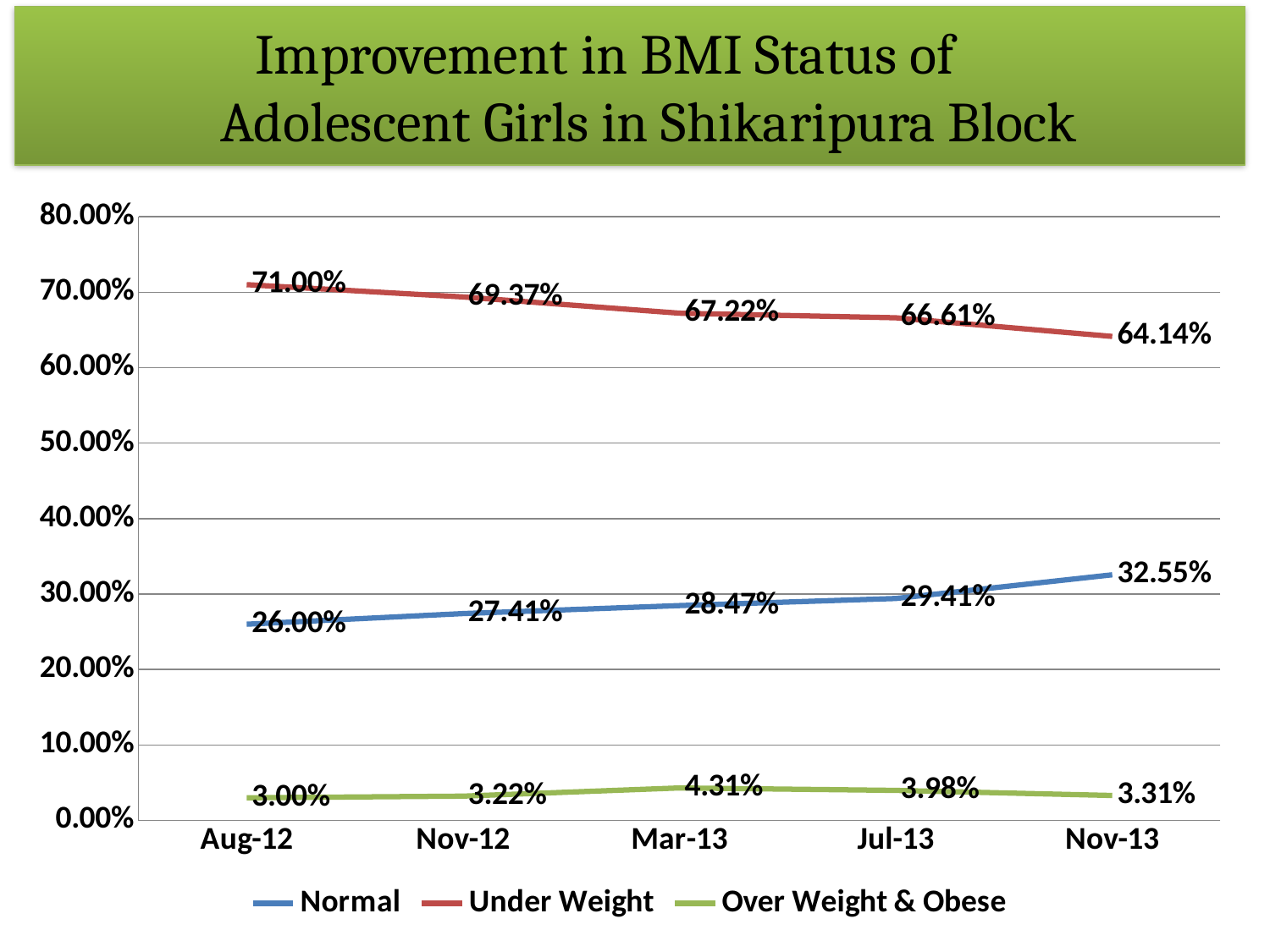
At which date is the Over Weight & Obese series highest? Mar-13 At which date is the Under Weight series lowest? Nov-13 How many dates are shown on the x axis? 5 How many series does the legend list? 3 Is the Under Weight value for Nov-13 greater or less than 60.00%? greater What is the Over Weight & Obese value for Mar-13? 4.31% What is the Normal value for Nov-13? 32.55% Which is larger, the Normal value for Nov-12 or the Normal value for Jul-13? Jul-13 What is the Under Weight value for Aug-12? 71.00% What kind of chart is shown on the slide? line chart What is the difference between the Under Weight values for Aug-12 and Nov-13? 6.86% What is the Under Weight value for Jul-13? 66.61%